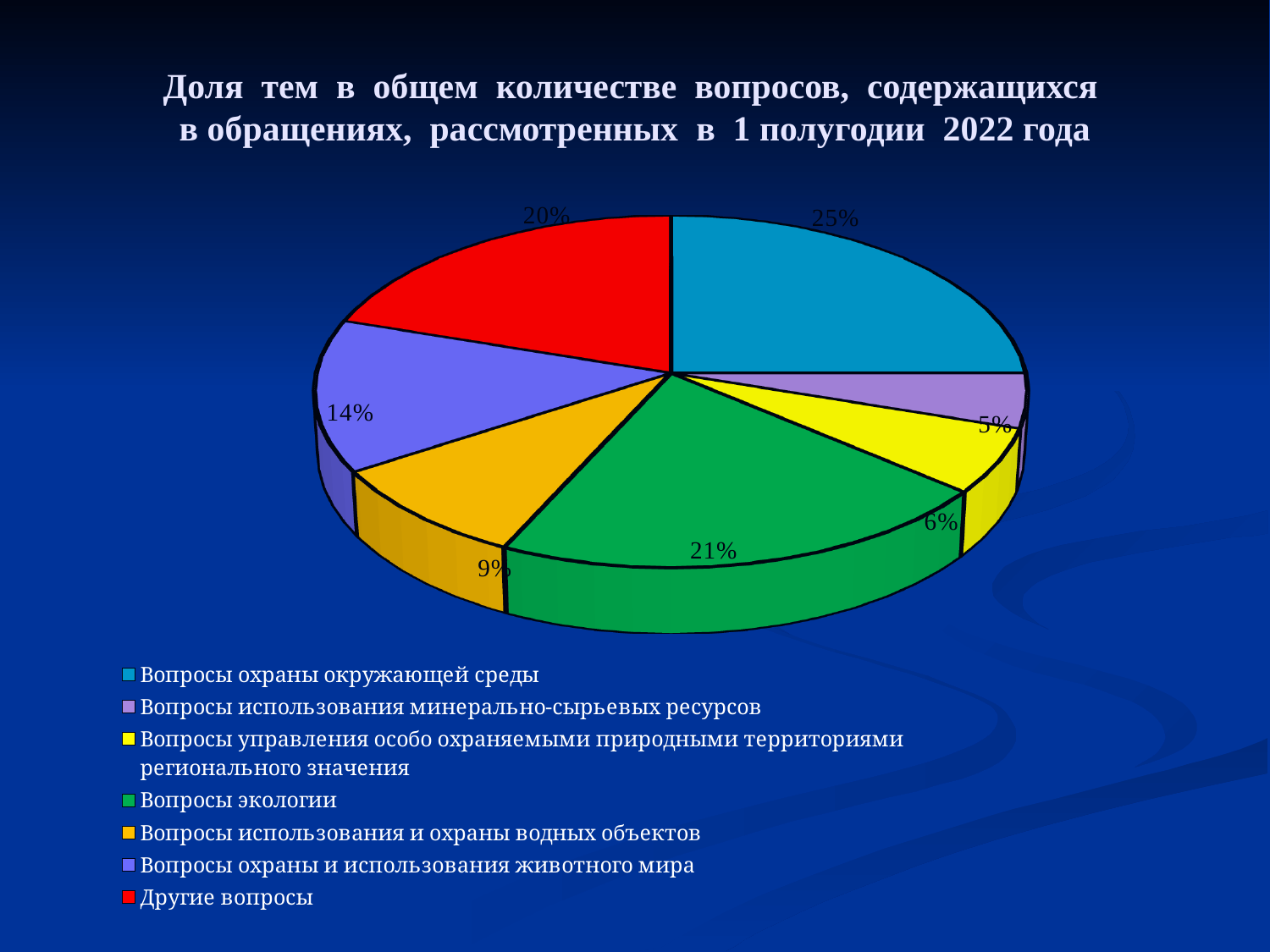
How many categories does the legend list? 7 What share of the pie is labelled for "Вопросы использования и охраны водных объектов"? 9% What share of the pie is labelled for "Вопросы охраны и использования животного мира"? 14% What share of the pie is labelled for "Вопросы охраны окружающей среды"? 25% What kind of chart is shown on the slide? pie chart Which category has the largest share of the pie? Вопросы охраны окружающей среды Which is larger: the share for "Вопросы охраны и использования животного мира" or the share for "Вопросы использования и охраны водных объектов"? Вопросы охраны и использования животного мира Which category has the smallest share of the pie? Вопросы использования минерально-сырьевых ресурсов What share of the pie is labelled for "Вопросы использования минерально-сырьевых ресурсов"? 5% What share of the pie is labelled for "Вопросы экологии"? 21% What is the difference in percentage points between the share for "Вопросы охраны окружающей среды" and the share for "Вопросы экологии"? 4 What share of the pie is labelled for "Другие вопросы"? 20%